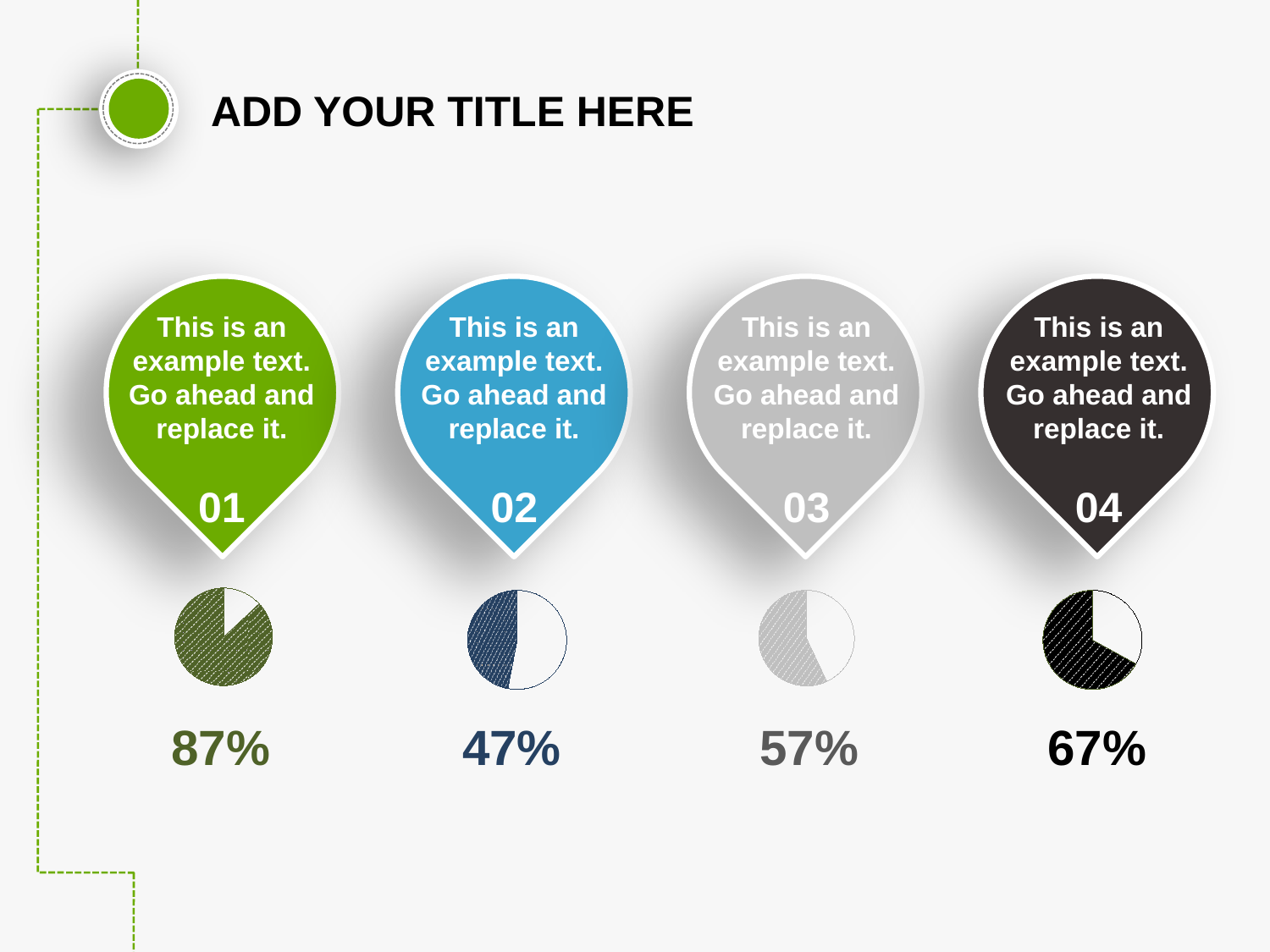
What percentage is shown below the pie chart under marker 03? 57% Which is larger, the percentage under marker 03 or the percentage under marker 04? 04 What kind of chart is shown below each numbered marker? Pie chart Which marker (01, 02, 03 or 04) has the highest percentage shown below its pie chart? 01 What percentage is shown below the pie chart under marker 01? 87% What percentage is shown below the pie chart under marker 04? 67% Which marker (01, 02, 03 or 04) has the lowest percentage shown below its pie chart? 02 What percentage is shown below the pie chart under marker 02? 47% How many pie charts are shown on the slide? 4 What share of the pie chart under marker 01 is filled by the shaded slice? 87% What is the difference between the percentage under marker 04 and the percentage under marker 03? 10% What is the difference between the percentage under marker 01 and the percentage under marker 02? 40%